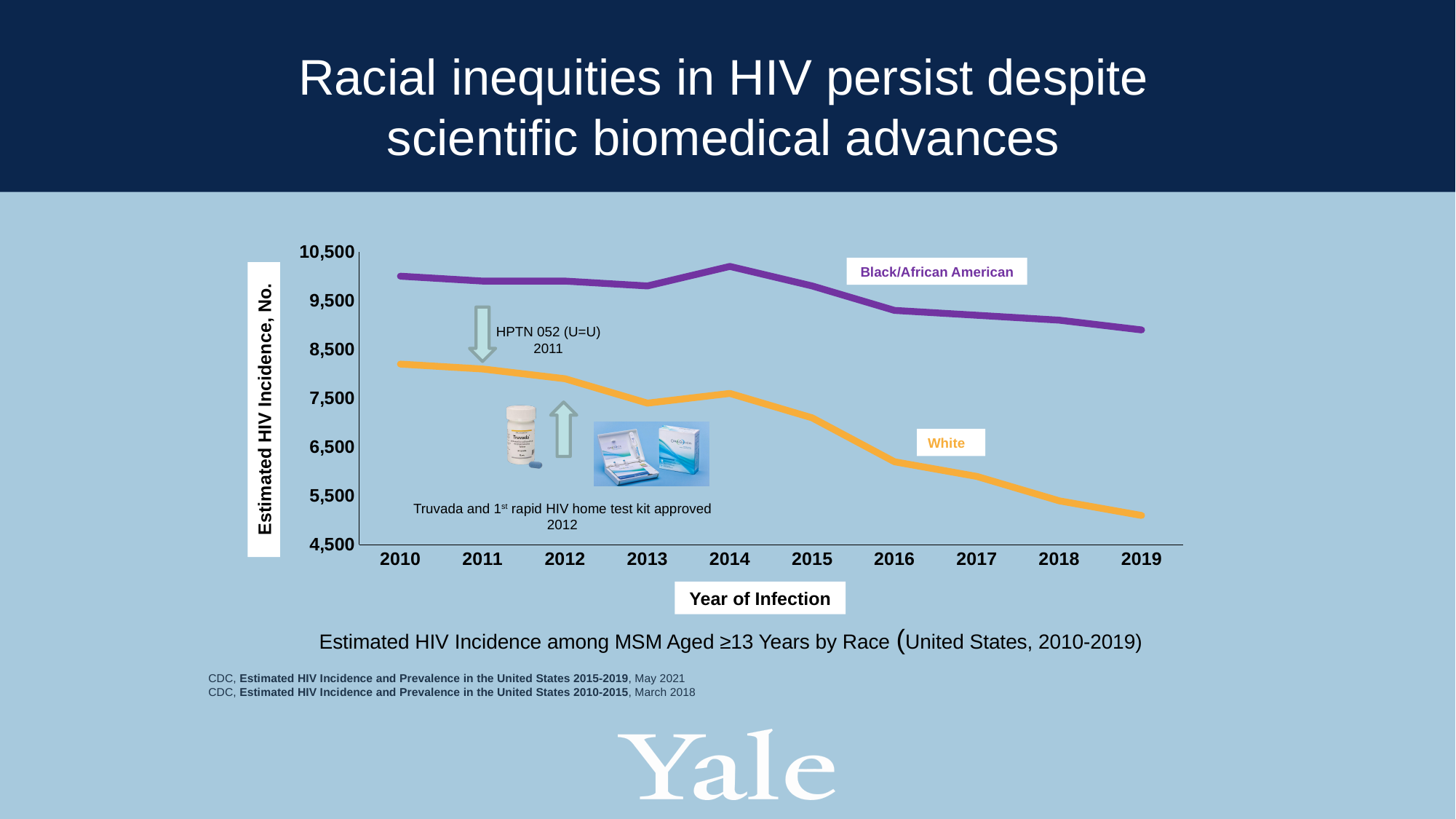
Is the value for Black/African American in 2014 greater or less than 9,500? greater What is the label of the y axis? Estimated HIV Incidence, No. How many series does the chart show? 2 Is the value for White in 2019 greater or less than 5,500? less In which year is the White series at its highest? 2010 Is the value for White in 2010 greater or less than 8,500? less Which series has the larger value in 2019, Black/African American or White? Black/African American In which year is the Black/African American series at its highest? 2014 Which series is plotted in purple? Black/African American How many years are plotted along the x axis? 10 In which year is the White series at its lowest? 2019 What kind of chart is shown on the slide? line chart